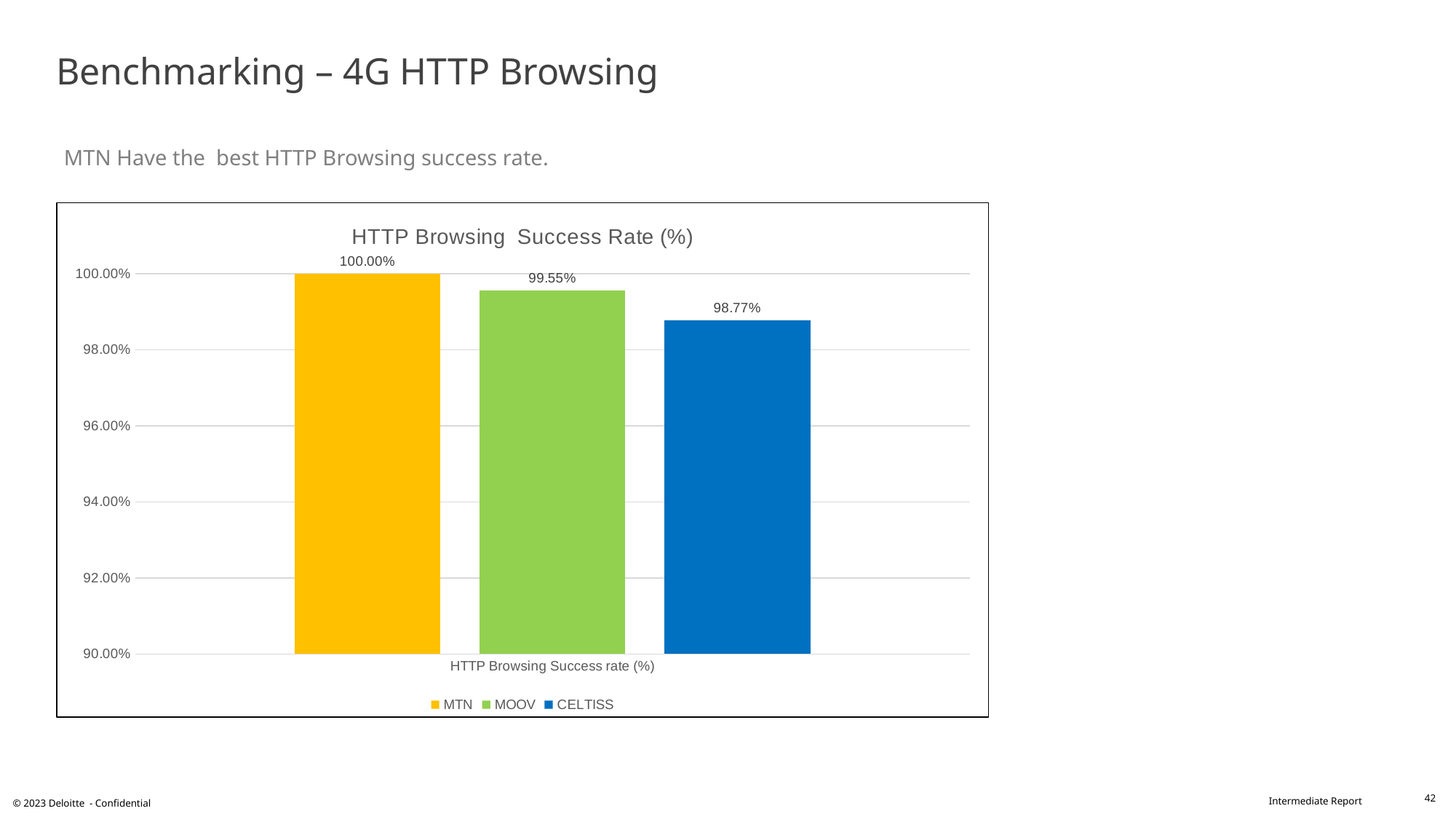
What is the title of the chart? HTTP Browsing Success Rate (%) What kind of chart is shown on the slide? Bar chart What is the HTTP Browsing success rate for MTN? 100.00% How many series does the legend list? 3 What is the difference between the HTTP Browsing success rates of MOOV and CELTISS? 0.78% Which operator has the lowest HTTP Browsing success rate? CELTISS What is the HTTP Browsing success rate for MOOV? 99.55% Which has a higher HTTP Browsing success rate, MOOV or CELTISS? MOOV Which operator has the highest HTTP Browsing success rate? MTN What is the HTTP Browsing success rate for CELTISS? 98.77% What is the difference between the HTTP Browsing success rates of MTN and CELTISS? 1.23% Is the value for CELTISS greater or less than 98.00%? greater